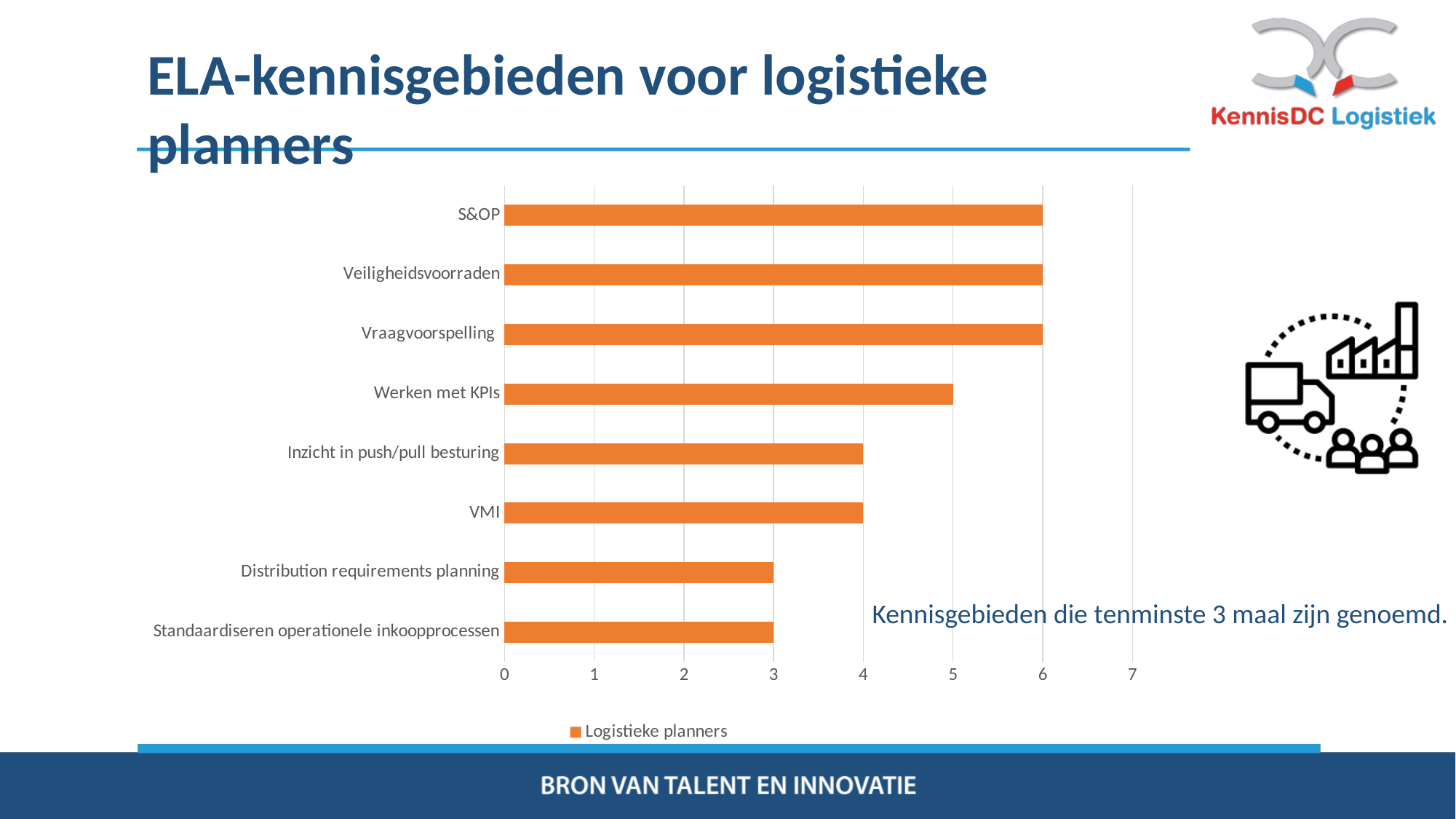
What is the value for Distribution requirements planning? 3 What is the value for Werken met KPIs? 5 Which is larger, the value for Werken met KPIs or the value for VMI? Werken met KPIs How many series does the legend list? 1 What kind of chart is shown on the slide? bar chart What is the value for S&OP? 6 What series name is shown in the legend? Logistieke planners What is the difference between the value for Vraagvoorspelling and the value for Standaardiseren operationele inkoopprocessen? 3 How many categories are plotted in the chart? 8 What is the value for VMI? 4 What is the value for Inzicht in push/pull besturing? 4 Is the value for Werken met KPIs greater or less than 4? greater